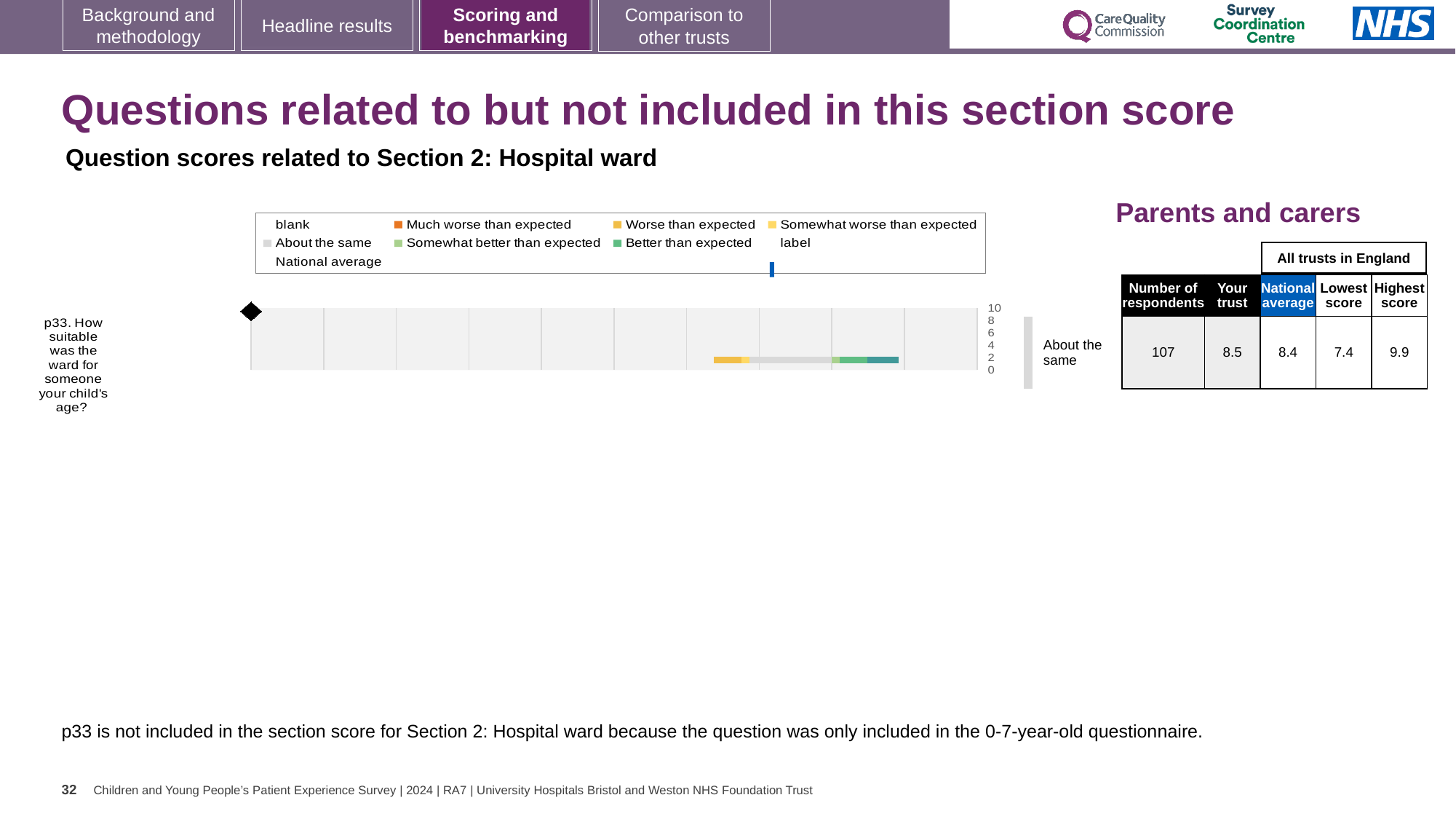
What is the highest score among all trusts in England for p33? 9.9 Which is higher for p33: the trust's score or the national average? Your trust (8.5) What benchmark category label is shown next to the p33 bar? About the same By how much does the trust's score for p33 exceed the national average? 0.1 What kind of chart is used to show the p33 question score? Bar chart What is the lowest score among all trusts in England for p33? 7.4 How many questions are plotted in the chart? 1 What is the 'Your trust' score for p33 (How suitable was the ward for someone your child's age?)? 8.5 What is the difference between the highest and lowest trust scores for p33? 2.5 Is the trust's score for p33 greater or less than 8? greater How many respondents answered p33? 107 What is the national average score for p33? 8.4